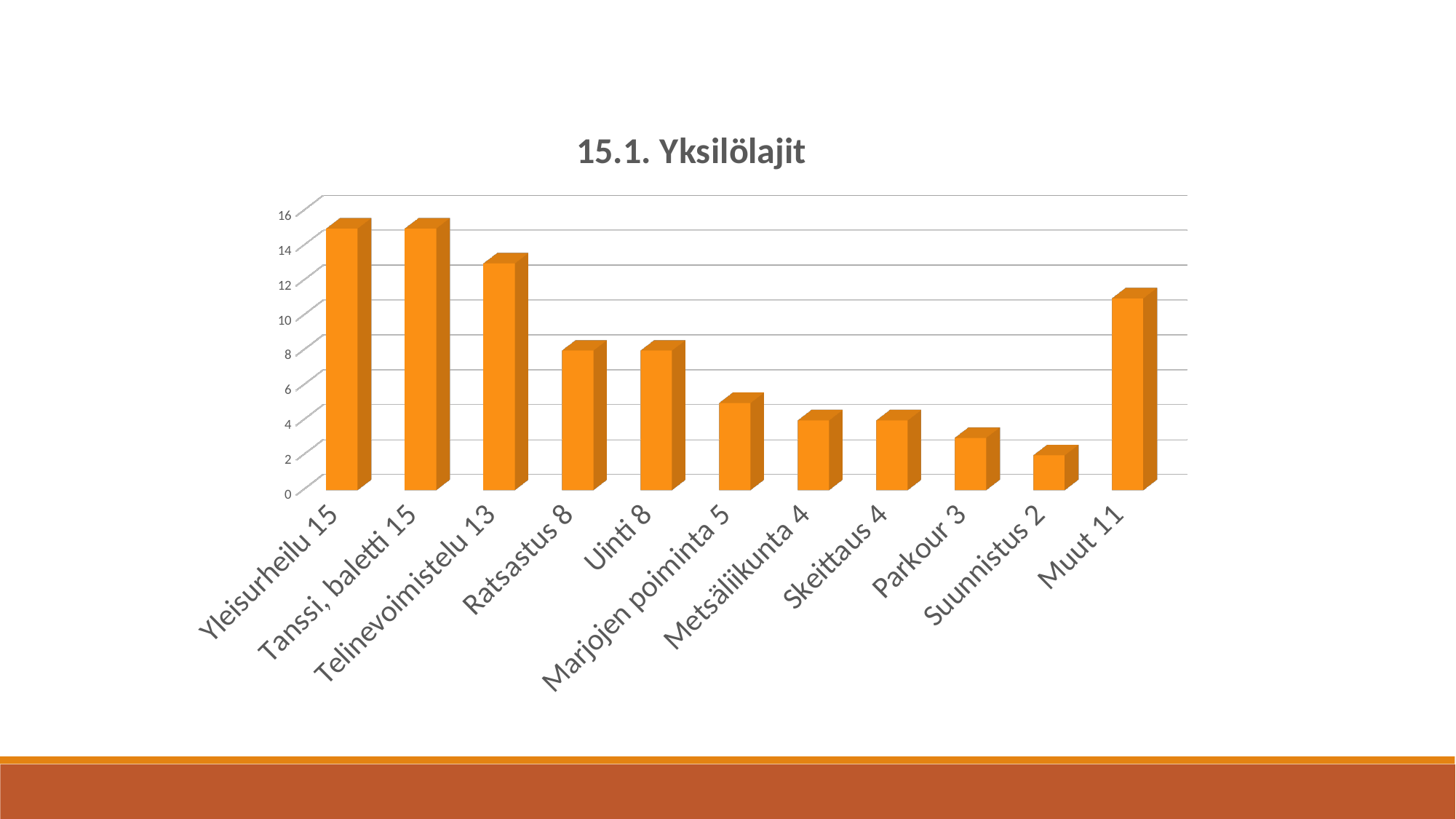
What is the difference between the values for Telinevoimistelu and Muut? 2 How many categories are shown in the chart? 11 What is the difference between the values for Ratsastus and Suunnistus? 6 What is the value for Parkour? 3 What is the value for Marjojen poiminta? 5 What is the value for Muut? 11 Which category has the lowest value? Suunnistus What is the value for Telinevoimistelu? 13 Is the value for Muut greater or less than 10? greater Which is larger, the value for Ratsastus or the value for Marjojen poiminta? Ratsastus What kind of chart is shown on the slide? bar chart What is the title of the chart? 15.1. Yksilölajit